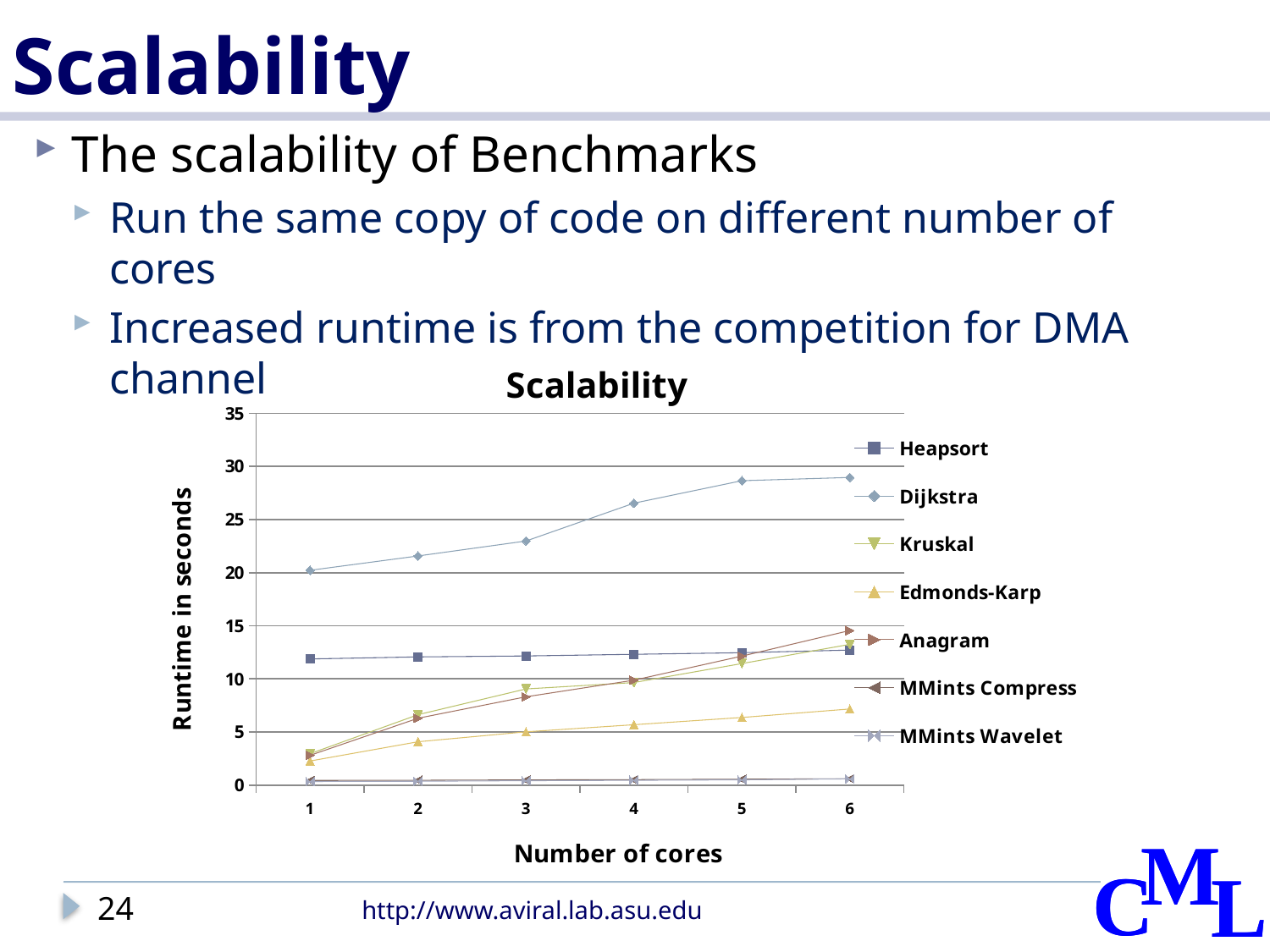
What kind of chart is shown on the slide? line chart At 3 cores, which has the larger runtime, Dijkstra or Heapsort? Dijkstra How many series does the legend of the Scalability chart list? 7 Is the runtime for Dijkstra at 6 cores greater or less than 25? greater At 6 cores, which has the larger runtime, Heapsort or Edmonds-Karp? Heapsort Which benchmark has the highest runtime at 6 cores? Dijkstra What is the label of the y axis of the chart? Runtime in seconds Does the runtime for Dijkstra rise or fall as the number of cores increases from 1 to 6? rise Is the runtime for Heapsort at 1 core greater or less than 15? less Is the runtime for Edmonds-Karp at 6 cores greater or less than 10? less How many values of Number of cores are plotted along the x axis? 6